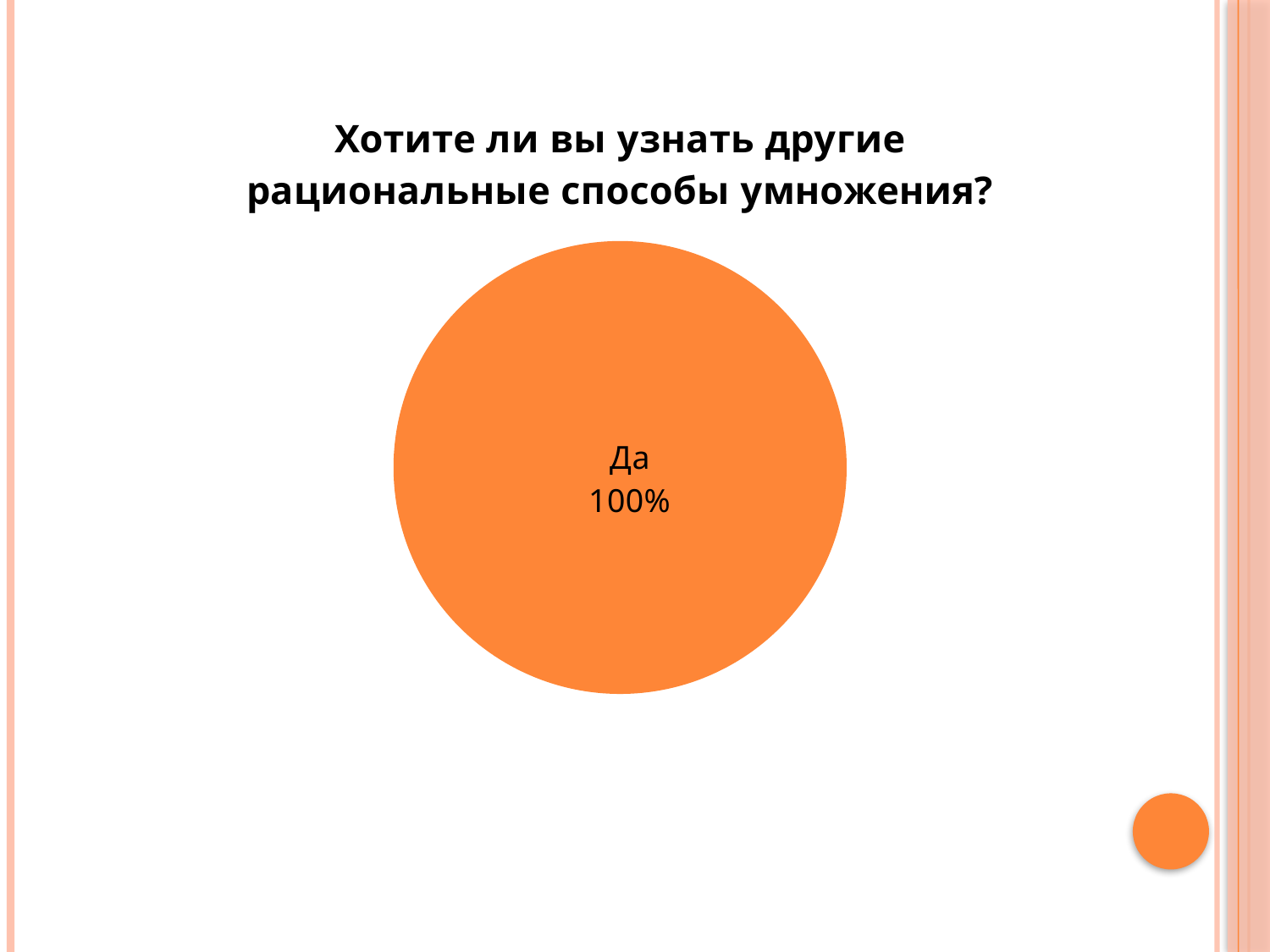
What is the value shown for the "Да" category? 100% How many slices does the pie chart have? 1 What colour is the "Да" slice of the pie? orange What kind of chart is shown on the slide? pie chart What share of the pie does the "Да" slice represent? 100% Which category has the largest share of the pie? Да Is the value for "Да" greater or less than 50%? greater What is the title of the chart? Хотите ли вы узнать другие рациональные способы умножения?